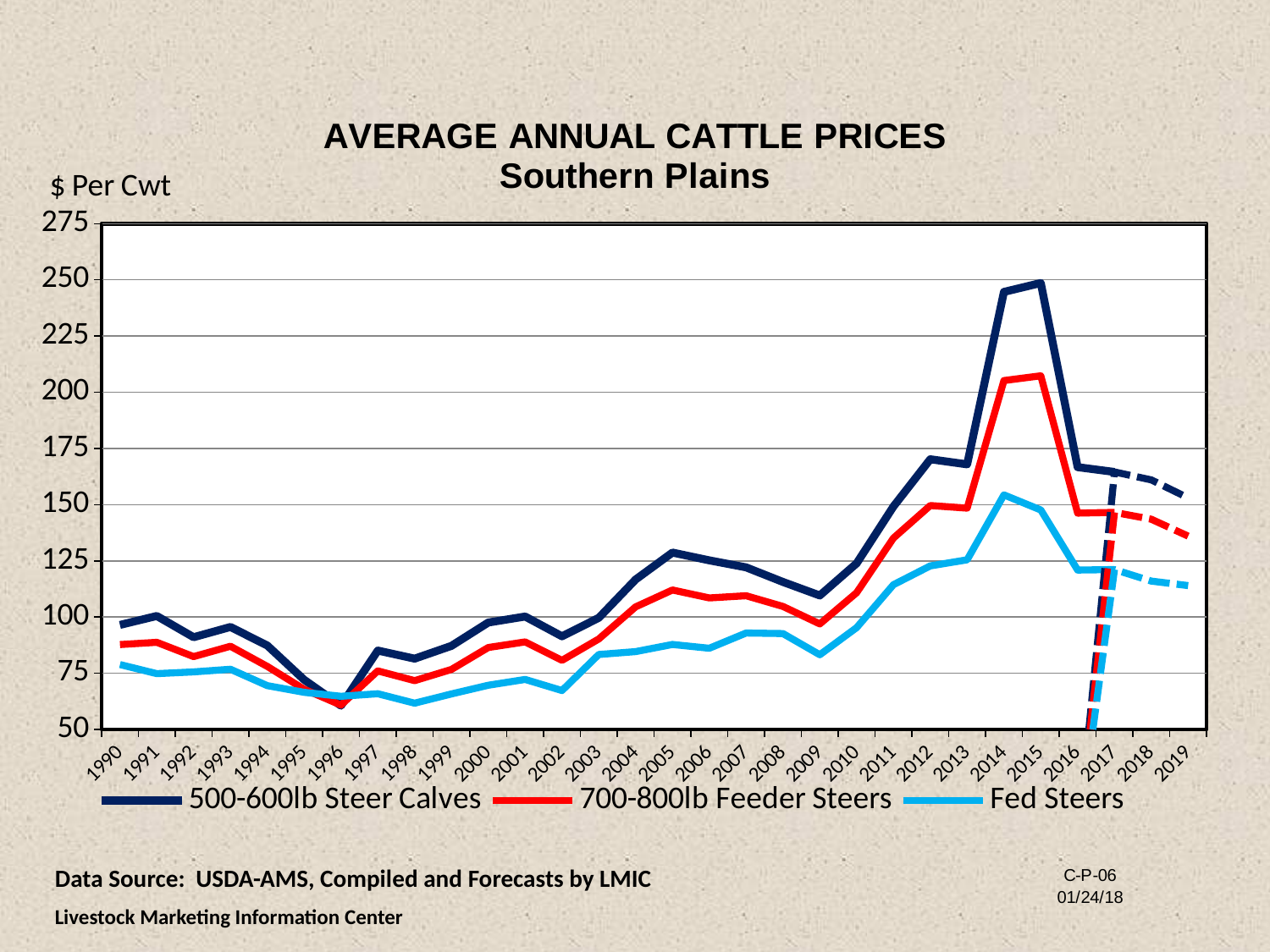
How many series does the legend list? 3 How many years are shown along the x axis? 30 Is the value for Fed Steers in 2009 greater or less than 100? less Is the value for 700-800lb Feeder Steers in 2015 greater or less than 175? greater In which year does the 700-800lb Feeder Steers series reach its lowest value? 1996 In 2015, which is larger: the value for 500-600lb Steer Calves or the value for Fed Steers? 500-600lb Steer Calves Is the value for 500-600lb Steer Calves in 1996 greater or less than 75? less Do the values for 500-600lb Steer Calves rise or fall from 2009 to 2014? rise In which year does the 500-600lb Steer Calves series reach its highest value? 2015 What kind of chart is shown on the slide? line chart What unit is shown on the y axis label? $ Per Cwt